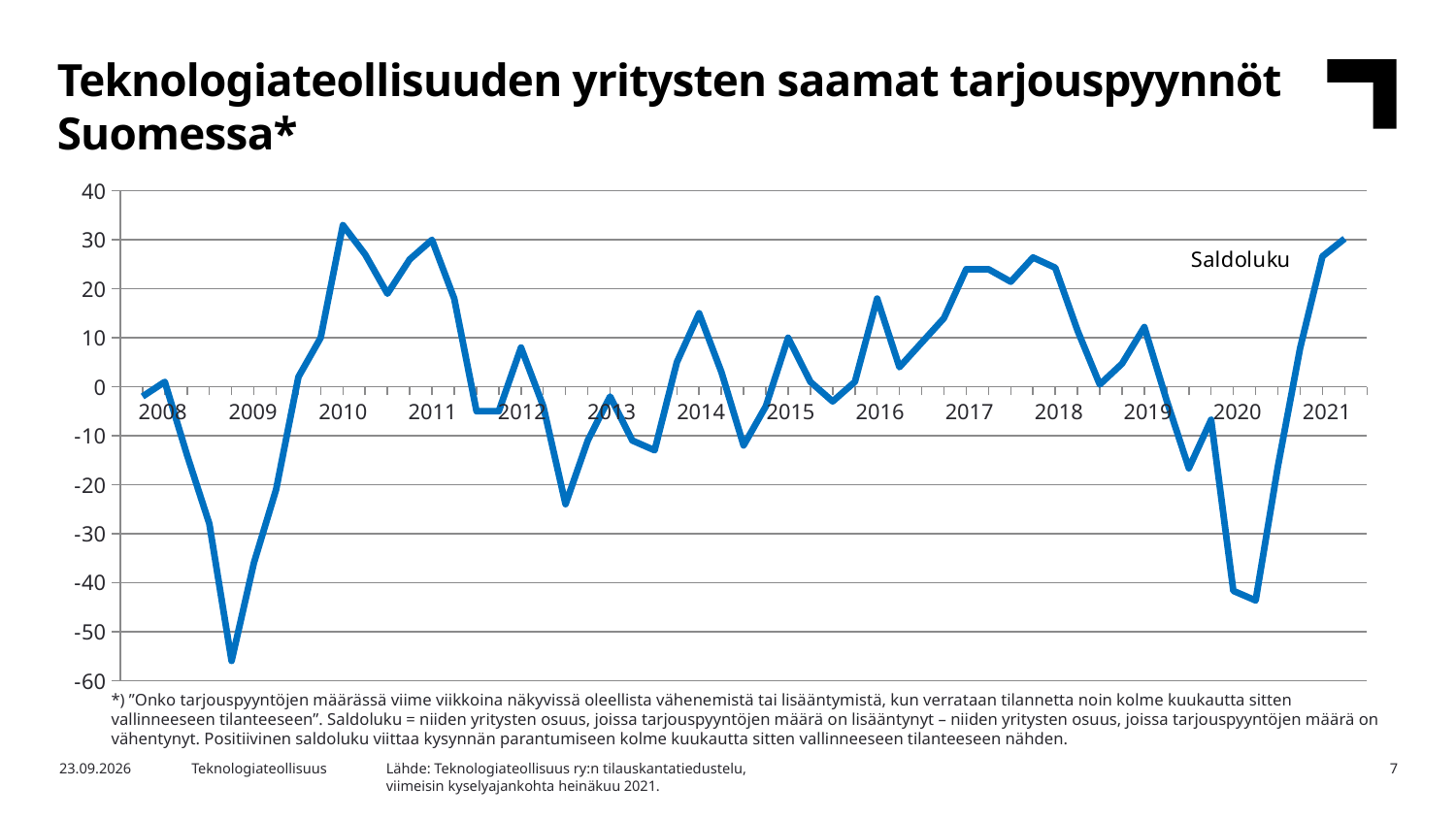
Does the line rise or fall between the low point in 2020 and the end of 2021? rise Is the lowest value of the line in 2009 greater or less than -50? less What is the title of the chart on the slide? Teknologiateollisuuden yritysten saamat tarjouspyynnöt Suomessa* How many series does the chart legend list? 1 What is the name of the series shown in the chart? Saldoluku What type of chart is shown on the slide? line chart How many year labels are shown on the x axis? 14 Is the lowest value of the line in 2020 greater or less than -30? less Is the lowest point in 2009 lower or higher than the lowest point in 2020? lower Is the last plotted value in 2021 greater or less than 20? greater Does the line rise or fall from the start of 2008 to the low point in 2009? fall In which year does the line reach its lowest point? 2009